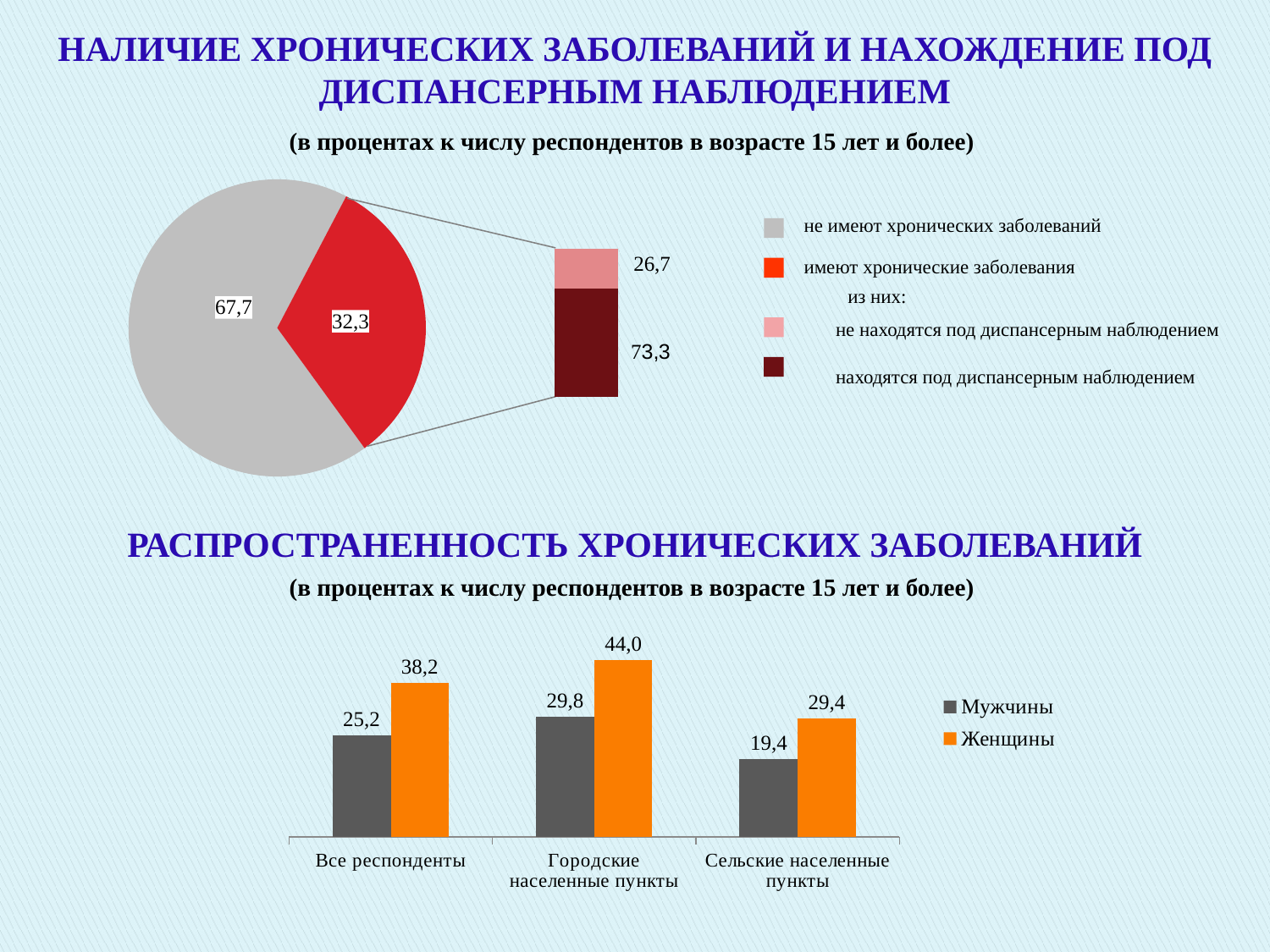
In the bottom chart, what is the value for Мужчины in the Сельские населенные пункты category? 19,4 In the bottom chart (Распространенность хронических заболеваний), what is the value for Женщины in the Городские населенные пункты category? 44,0 How many series does the legend of the bottom chart list? 2 In the bottom chart, what is the difference between Женщины and Мужчины in the Все респонденты category? 13,0 In the bottom chart, which category has the highest value for Мужчины? Городские населенные пункты In the top chart (Наличие хронических заболеваний), what percentage of respondents do not have chronic diseases (не имеют хронических заболеваний)? 67,7 In the top chart, among those with chronic diseases, what share is not under dispensary observation (не находятся под диспансерным наблюдением)? 26,7 What type of chart is the top chart on the slide? Pie chart What type of chart is the bottom chart on the slide? Bar chart In the top chart, among those with chronic diseases, what share is under dispensary observation (находятся под диспансерным наблюдением)? 73,3 In the top chart, what percentage of respondents have chronic diseases (имеют хронические заболевания)? 32,3 In the bottom chart, which category has the lowest value for Женщины? Сельские населенные пункты